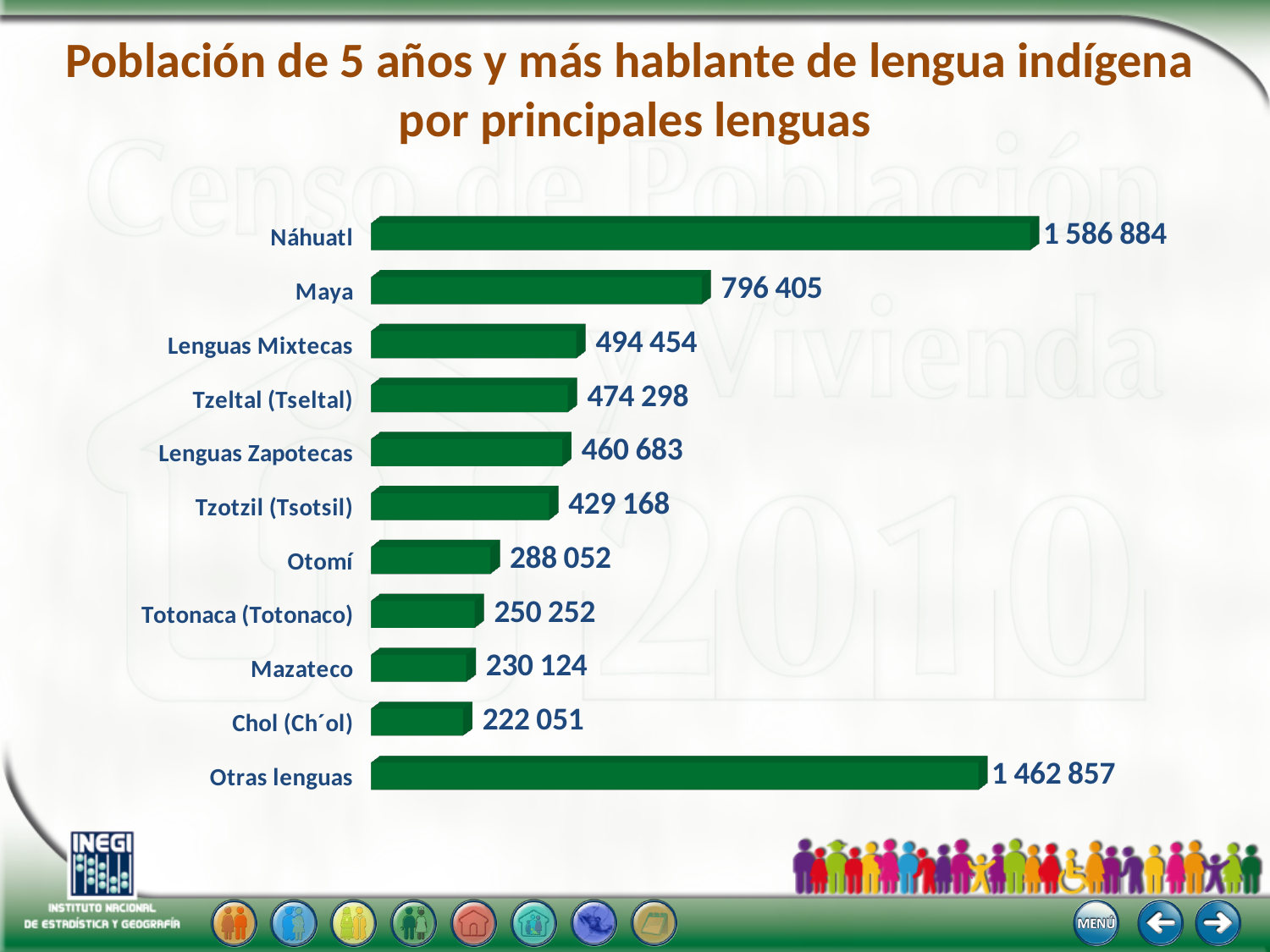
What is the value shown for Tzotzil (Tsotsil)? 429 168 What is the difference between the values for Otomí and Totonaca (Totonaco)? 37 800 What is the title of the chart on the slide? Población de 5 años y más hablante de lengua indígena por principales lenguas Which language has the lowest value on the chart? Chol (Ch´ol) What is the difference between the values for Náhuatl and Maya? 790 479 What is the value shown for Otras lenguas? 1 462 857 What is the value shown for Maya? 796 405 What is the value shown for Náhuatl? 1 586 884 Which has a larger value, Lenguas Mixtecas or Lenguas Zapotecas? Lenguas Mixtecas What kind of chart is shown on the slide? Bar chart How many language categories are shown on the chart? 11 Which language has the highest value on the chart? Náhuatl